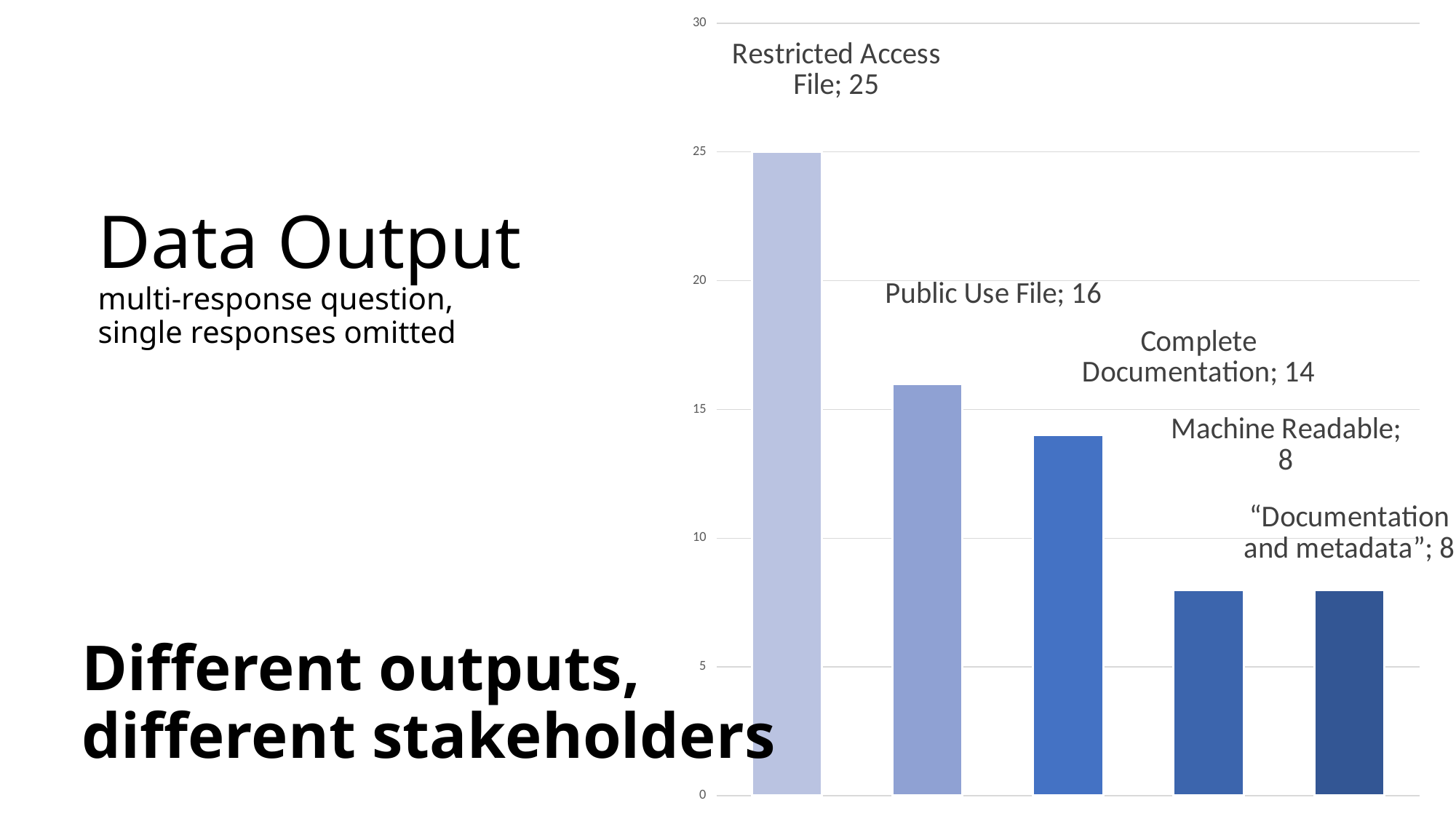
Is the value for Restricted Access File greater or less than 20? greater Which category has the highest value? Restricted Access File What is the value for Complete Documentation? 14 What is the value for Machine Readable? 8 What is the value for Public Use File? 16 What is the difference between the values for Restricted Access File and Public Use File? 9 What is the value for Restricted Access File? 25 What kind of chart is shown on the slide? bar chart How many categories are plotted in the chart? 5 What is the difference between the values for Complete Documentation and Machine Readable? 6 Which is larger, the value for Public Use File or the value for Complete Documentation? Public Use File Do the values rise or fall from left to right across the bars? fall